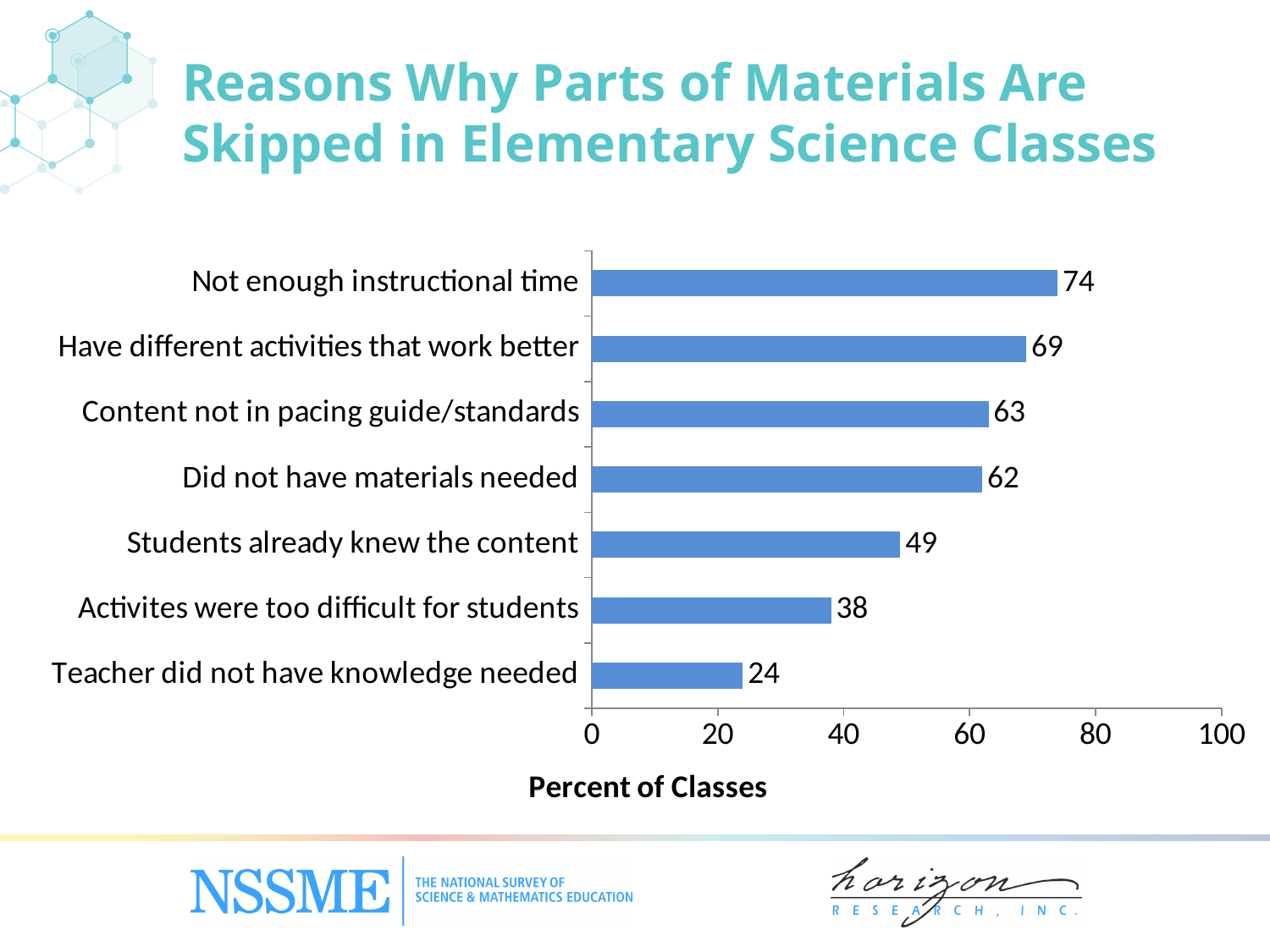
What is the value for "Teacher did not have knowledge needed"? 24 Which reason has the lowest percent of classes? Teacher did not have knowledge needed Which reason has the highest percent of classes? Not enough instructional time Is the value for "Did not have materials needed" greater or less than 60? greater What is the label of the horizontal axis? Percent of Classes What is the difference between the values for "Students already knew the content" and "Activites were too difficult for students"? 11 What kind of chart is shown on the slide? Bar chart What is the difference between the values for "Not enough instructional time" and "Have different activities that work better"? 5 What percent of classes skipped parts of materials because there was not enough instructional time? 74 Which is larger: the value for "Content not in pacing guide/standards" or "Activites were too difficult for students"? Content not in pacing guide/standards What is the value for "Students already knew the content"? 49 How many reasons are shown in the chart? 7